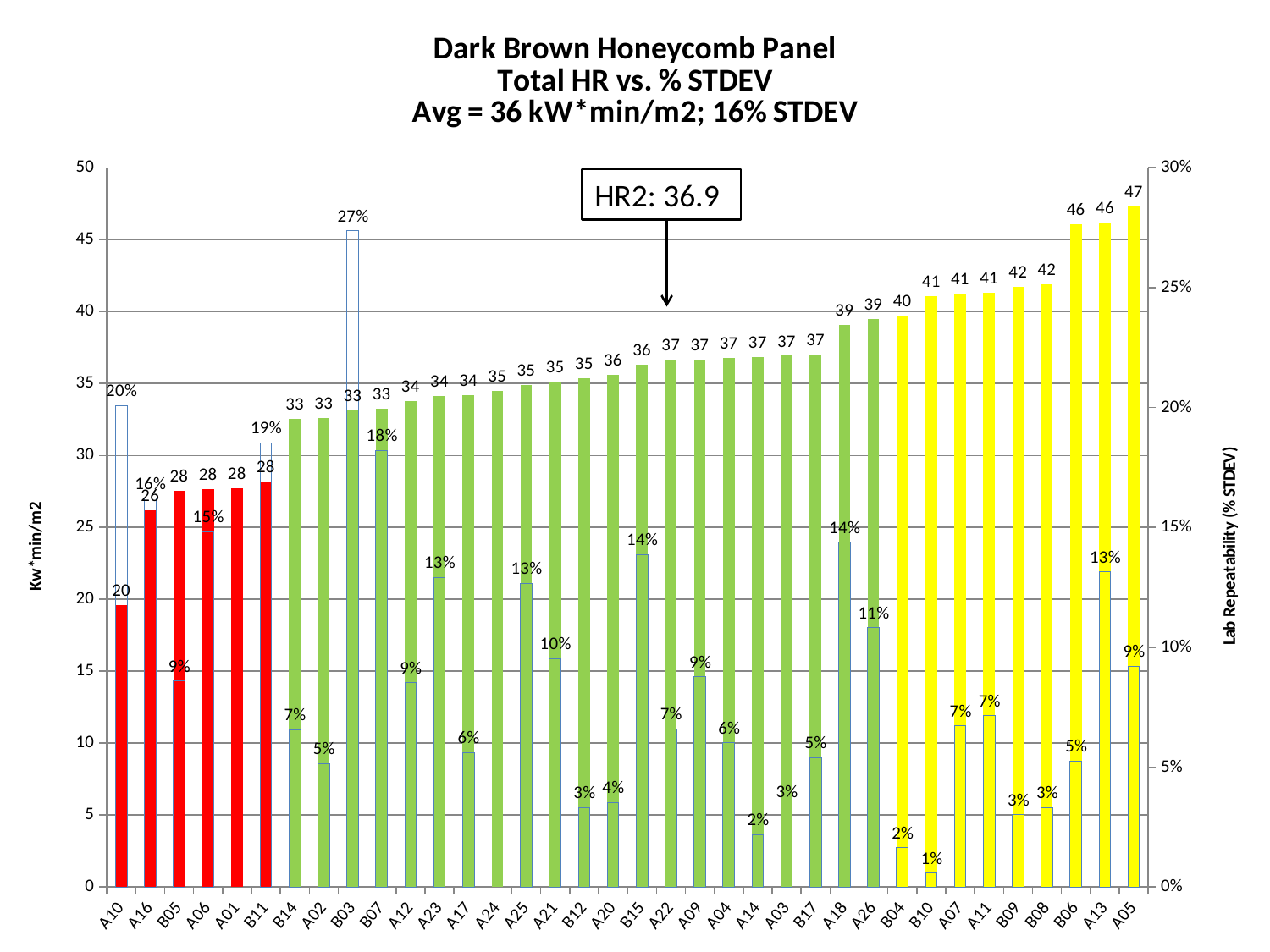
What kind of chart is this? Bar chart Which sample has the highest % STDEV value? B03 Do the Total HR values rise or fall from left to right along the x axis? Rise What is the Total HR value (kW*min/m2) for A05? 47 What is the difference in Total HR between A05 and A10? 27 How many samples are shown on the x axis? 36 Which has a larger Total HR value, B06 or B04? B06 Which sample has the lowest % STDEV value? B10 Which sample has the lowest Total HR value? A10 Which sample has the highest Total HR value? A05 What is the Lab Repeatability (% STDEV) value for B07? 18% What HR2 value is shown in the annotation box on the chart? 36.9